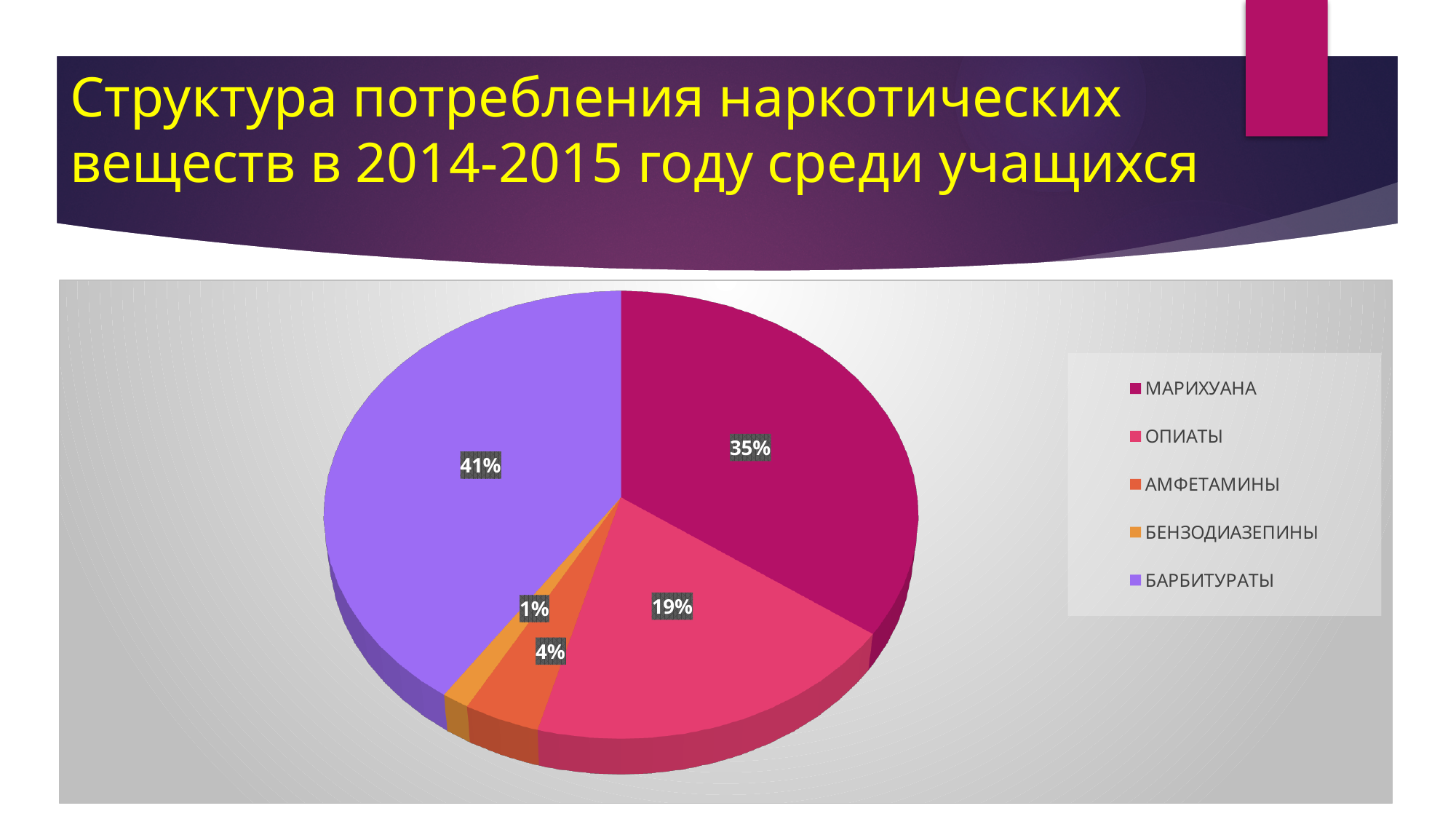
Which category has the largest slice of the pie? БАРБИТУРАТЫ Which is larger, the share of ОПИАТЫ or the share of АМФЕТАМИНЫ? ОПИАТЫ What kind of chart is shown on the slide? pie chart How many categories does the pie chart have? 5 What share of the pie does МАРИХУАНА have? 35% What share of the pie does БАРБИТУРАТЫ have? 41% What share of the pie does ОПИАТЫ have? 19% What is the difference between the shares of БАРБИТУРАТЫ and МАРИХУАНА? 6% What is the title of the slide containing the chart? Структура потребления наркотических веществ в 2014-2015 году среди учащихся Which category has the smallest slice of the pie? БЕНЗОДИАЗЕПИНЫ